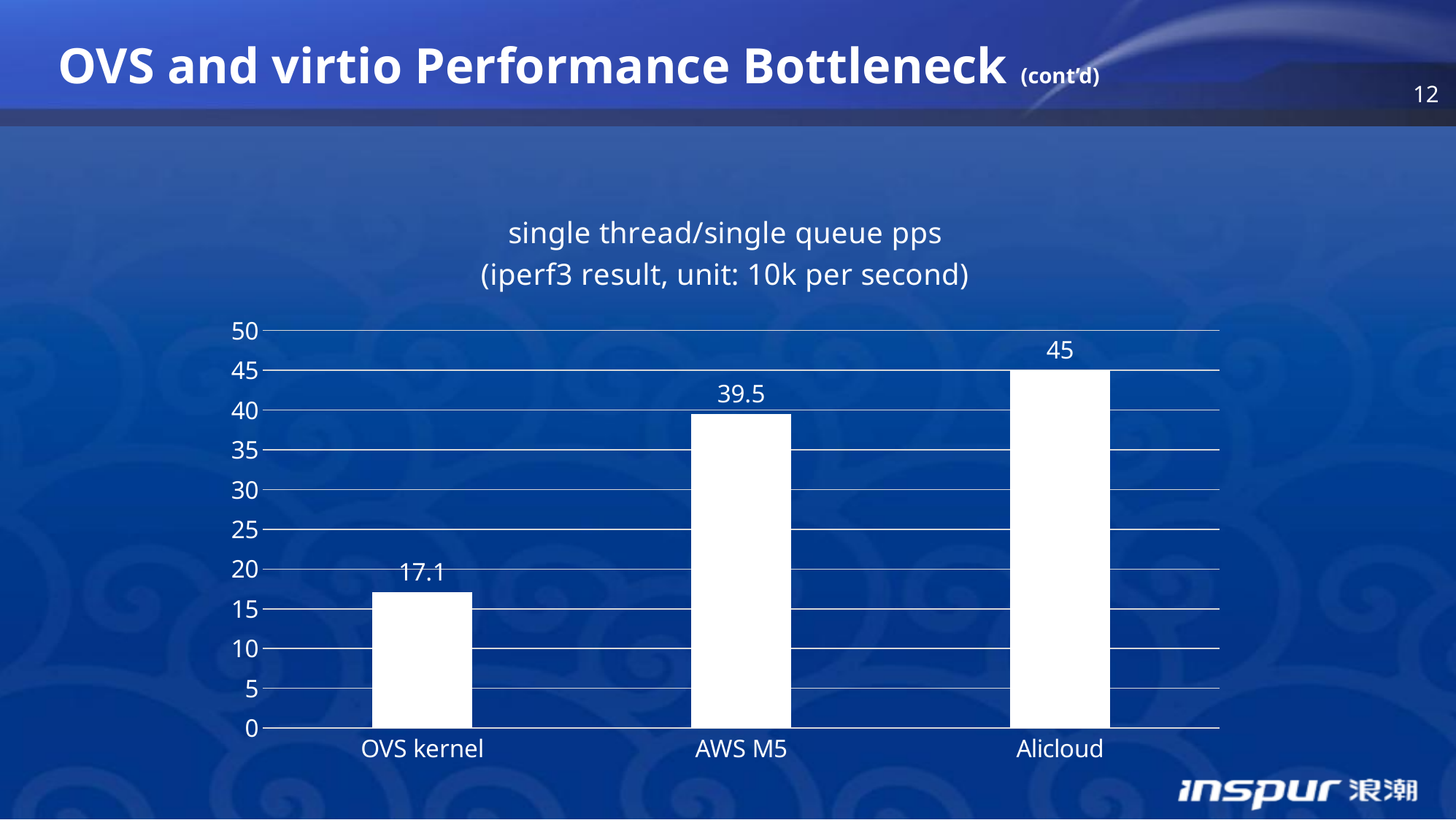
What is the title of the chart? single thread/single queue pps (iperf3 result, unit: 10k per second) What is the value for OVS kernel? 17.1 What is the value for AWS M5? 39.5 What is the difference between the values for AWS M5 and OVS kernel? 22.4 Which is larger, the value for AWS M5 or the value for OVS kernel? AWS M5 Which category has the lowest value? OVS kernel Is the value for OVS kernel greater or less than 20? less What is the difference between the values for Alicloud and AWS M5? 5.5 What kind of chart is shown on the slide? bar chart How many categories are shown on the x axis? 3 Which category has the highest value? Alicloud What is the value for Alicloud? 45